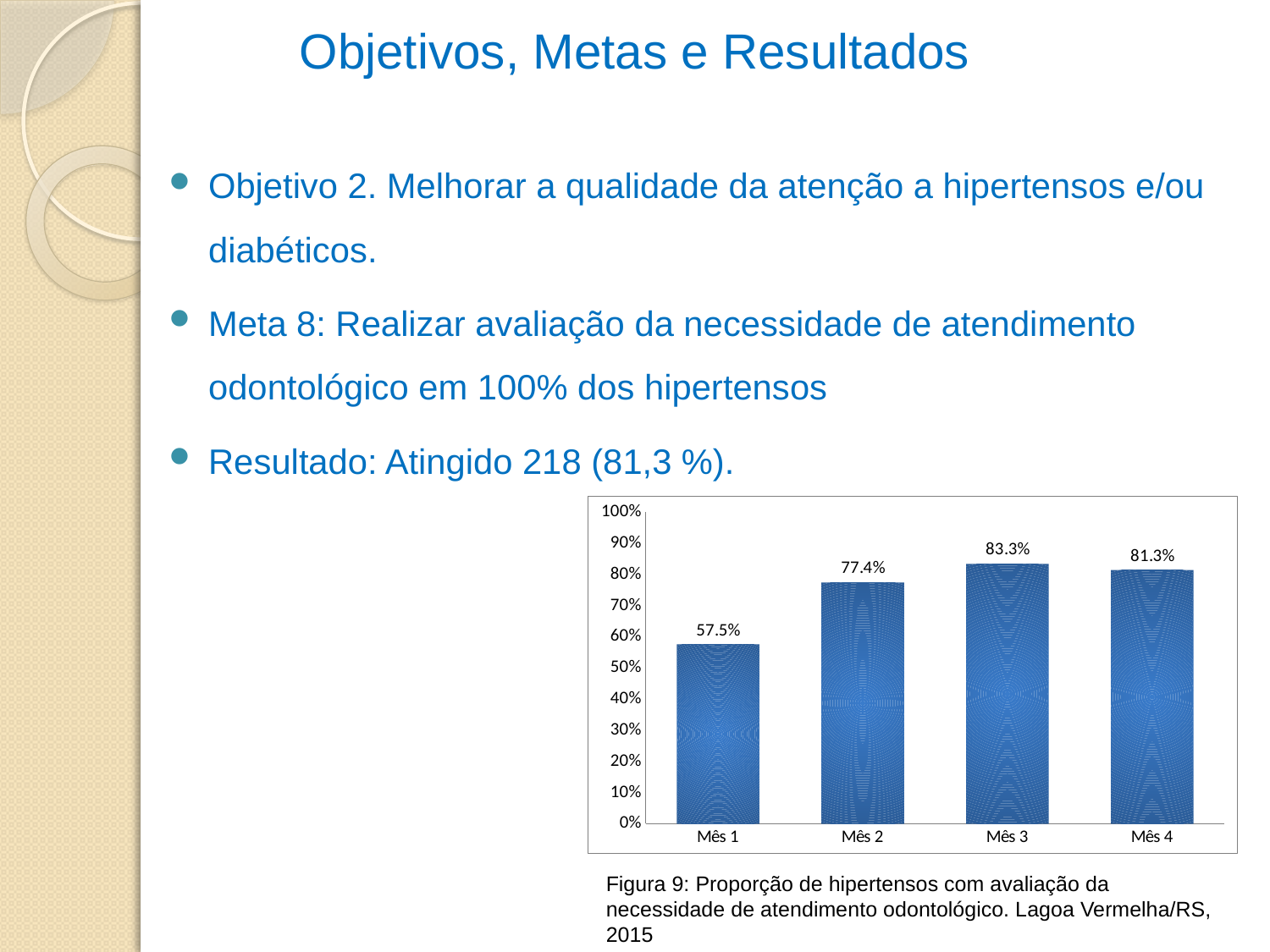
What is the value for Mês 3? 83.3% How many months are shown on the x axis? 4 Does the value rise or fall from Mês 1 to Mês 3? Rise What is the value for Mês 4? 81.3% What is the difference between the values for Mês 2 and Mês 1? 19.9% What is the value for Mês 1? 57.5% What is the difference between the values for Mês 3 and Mês 4? 2.0% What is the value for Mês 2? 77.4% Which month has the highest value? Mês 3 Which month has the lowest value? Mês 1 Which is larger, the value for Mês 2 or the value for Mês 4? Mês 4 What kind of chart is shown on the slide? Bar chart